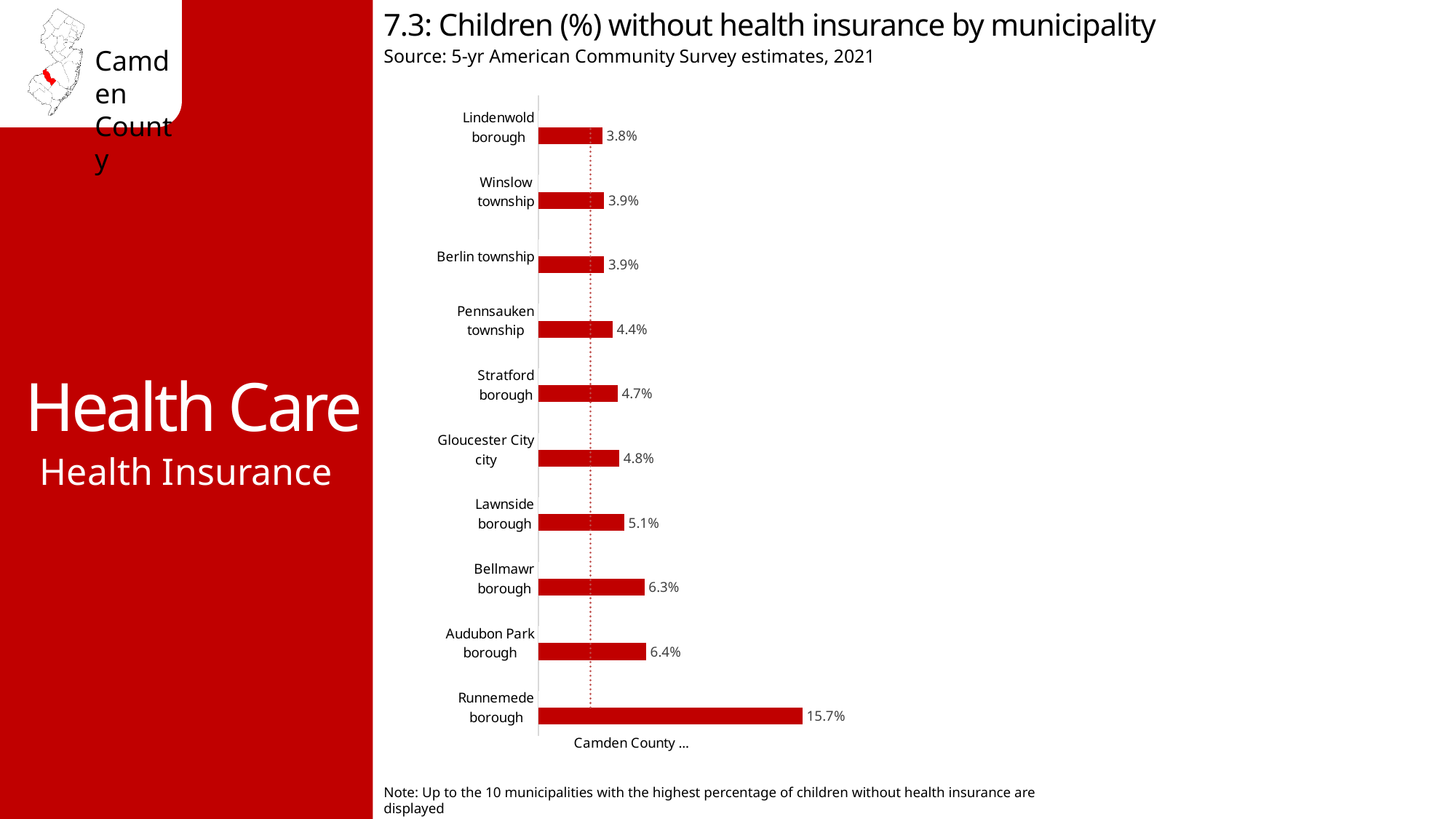
What is the source cited for the chart? 5-yr American Community Survey estimates, 2021 Which municipality has the lowest percentage of children without health insurance? Lindenwold borough What is the difference between the values for Lawnside borough and Stratford borough? 0.4% What is the value shown for Bellmawr borough? 6.3% What is the difference between the values for Runnemede borough and Audubon Park borough? 9.3% Which has a higher value, Gloucester City city or Winslow township? Gloucester City city What kind of chart is shown on the slide? Bar chart What is the value shown for Pennsauken township? 4.4% Do the values increase or decrease going from the top bar to the bottom bar? Increase Which municipality has the highest percentage of children without health insurance? Runnemede borough How many municipalities are shown in the chart? 10 What percentage of children are without health insurance in Runnemede borough? 15.7%